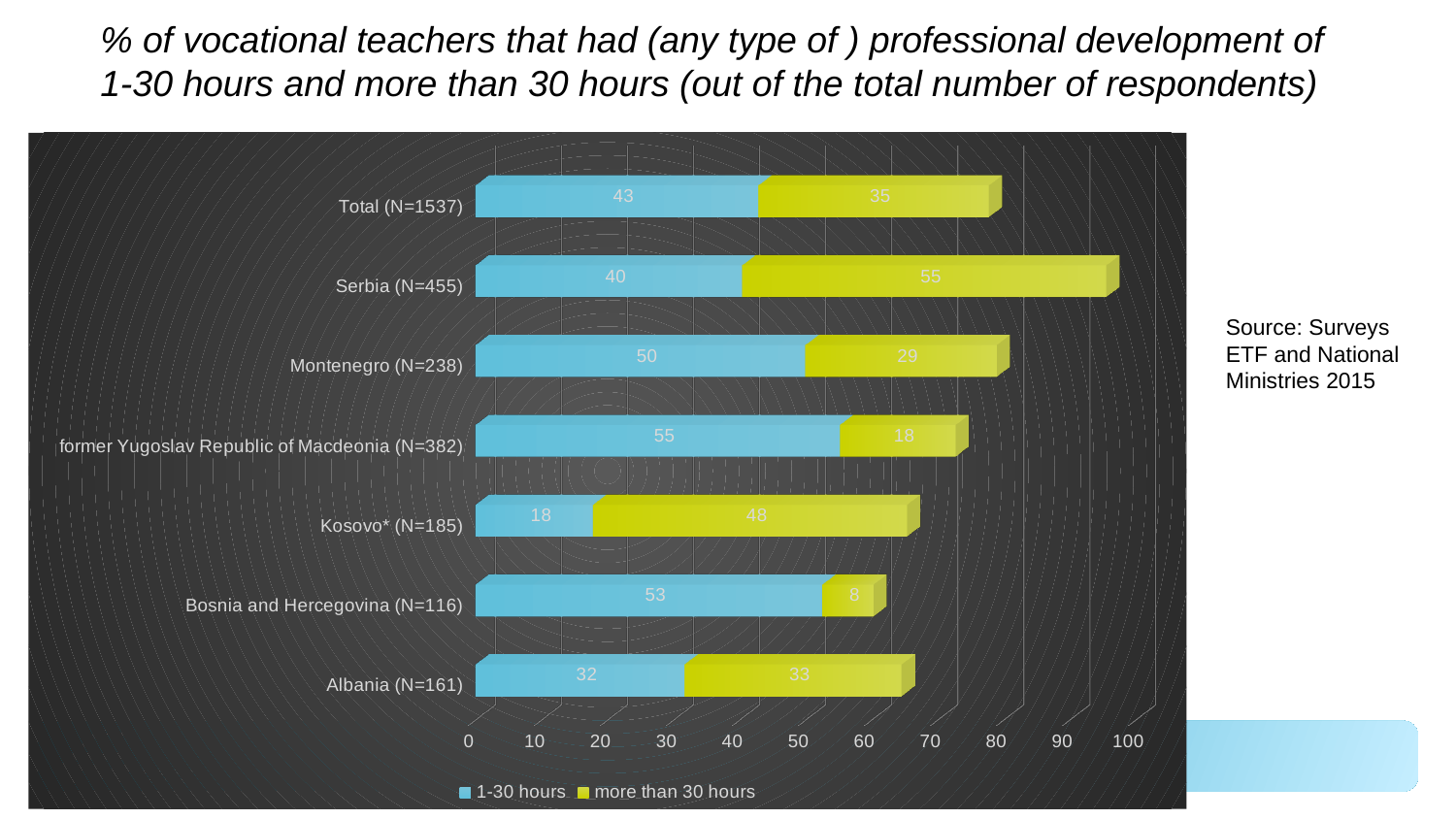
How many categories are shown on the chart? 7 What is the value for 1-30 hours for Kosovo* (N=185)? 18 How many series does the legend list? 2 What is the value for more than 30 hours for Bosnia and Hercegovina (N=116)? 8 What kind of chart is shown on the slide? Stacked bar chart What is the difference between the 1-30 hours value and the more than 30 hours value for Montenegro (N=238)? 21 Which category has the highest value for the 1-30 hours series? former Yugoslav Republic of Macdeonia (N=382) What is the total of the stacked bar for Serbia (N=455)? 95 What is the total of the stacked bar for Total (N=1537)? 78 Which category has the lowest value for the more than 30 hours series? Bosnia and Hercegovina (N=116) What percentage of vocational teachers in Serbia (N=455) had more than 30 hours of professional development? 55 Which is larger for Albania (N=161): the 1-30 hours value or the more than 30 hours value? more than 30 hours